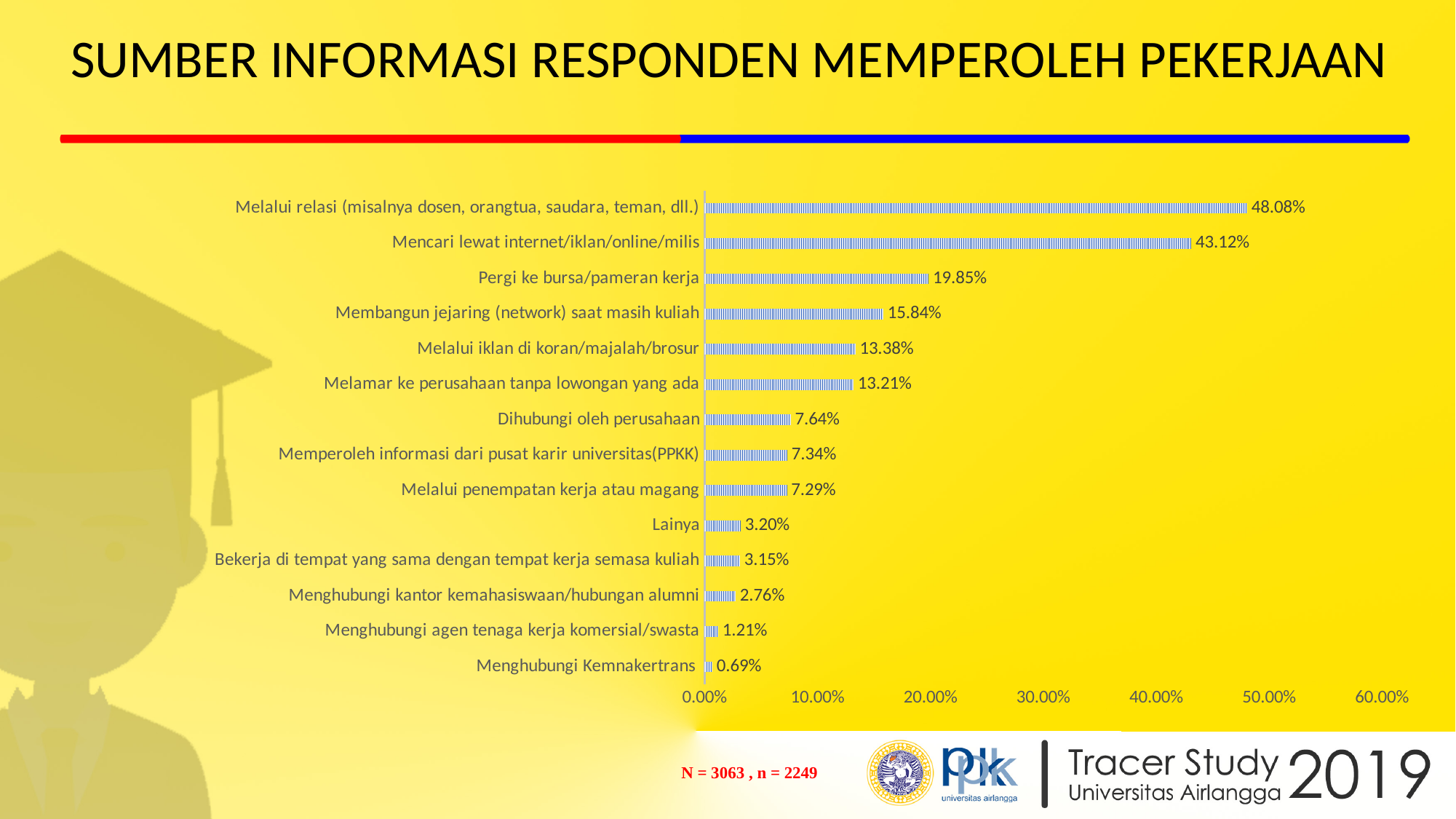
What is the value for 'Pergi ke bursa/pameran kerja'? 19.85% What is the value for 'Menghubungi Kemnakertrans'? 0.69% Which category has the lowest value? Menghubungi Kemnakertrans Is the value for 'Mencari lewat internet/iklan/online/milis' greater or less than 40.00%? greater What is the title of the slide? SUMBER INFORMASI RESPONDEN MEMPEROLEH PEKERJAAN Which category has the highest value? Melalui relasi (misalnya dosen, orangtua, saudara, teman, dll.) Which is larger: 'Membangun jejaring (network) saat masih kuliah' or 'Melalui iklan di koran/majalah/brosur'? Membangun jejaring (network) saat masih kuliah What is the difference between 'Melalui relasi (misalnya dosen, orangtua, saudara, teman, dll.)' and 'Mencari lewat internet/iklan/online/milis'? 4.96% How many categories are shown in the chart? 14 What is the value for 'Dihubungi oleh perusahaan'? 7.64% What percentage of respondents obtained job information through 'Melalui relasi (misalnya dosen, orangtua, saudara, teman, dll.)'? 48.08% What type of chart is shown on the slide? Bar chart